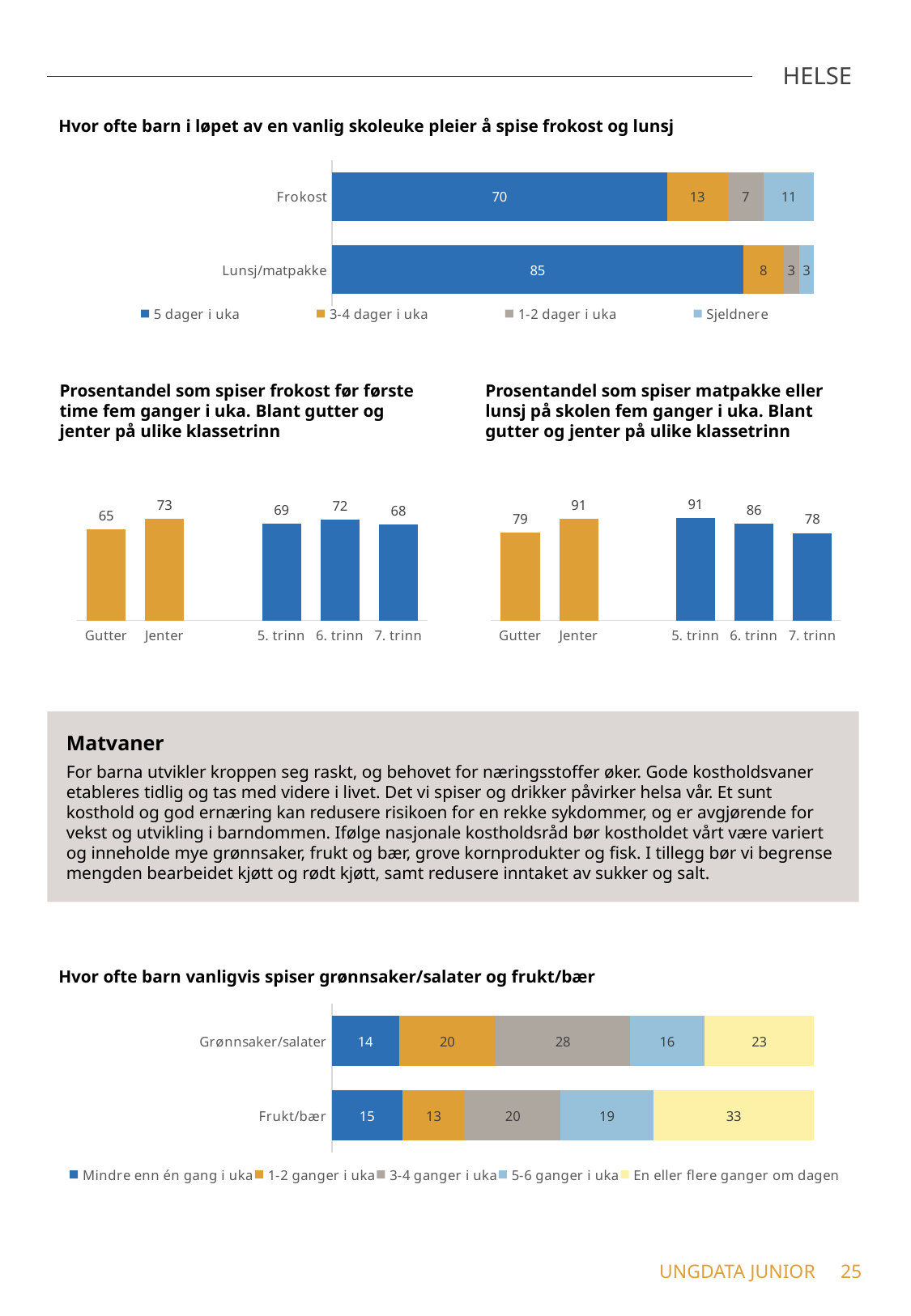
In the top chart 'Hvor ofte barn i løpet av en vanlig skoleuke pleier å spise frokost og lunsj', how many series does the legend list? 4 What kind of chart is the bottom chart 'Hvor ofte barn vanligvis spiser grønnsaker/salater og frukt/bær'? stacked bar chart In the middle-right chart 'Prosentandel som spiser matpakke eller lunsj på skolen fem ganger i uka', do the values rise or fall from 5. trinn to 7. trinn? fall In the top chart 'Hvor ofte barn i løpet av en vanlig skoleuke pleier å spise frokost og lunsj', what is the difference between the '5 dager i uka' values for Lunsj/matpakke and Frokost? 15 In the middle-right chart 'Prosentandel som spiser matpakke eller lunsj på skolen fem ganger i uka', which is larger, the value for Gutter or the value for Jenter? Jenter In the top chart 'Hvor ofte barn i løpet av en vanlig skoleuke pleier å spise frokost og lunsj', what is the value for '5 dager i uka' for Frokost? 70 In the bottom chart 'Hvor ofte barn vanligvis spiser grønnsaker/salater og frukt/bær', what is the value for 'En eller flere ganger om dagen' for Frukt/bær? 33 In the middle-left chart 'Prosentandel som spiser frokost før første time fem ganger i uka', which category has the lowest value? Gutter In the middle-left chart 'Prosentandel som spiser frokost før første time fem ganger i uka', what is the value for Jenter? 73 In the middle-right chart 'Prosentandel som spiser matpakke eller lunsj på skolen fem ganger i uka', what is the value for 6. trinn? 86 In the top chart 'Hvor ofte barn i løpet av en vanlig skoleuke pleier å spise frokost og lunsj', what is the value for 'Sjeldnere' for Lunsj/matpakke? 3 In the middle-left chart 'Prosentandel som spiser frokost før første time fem ganger i uka', how many bars are plotted? 5